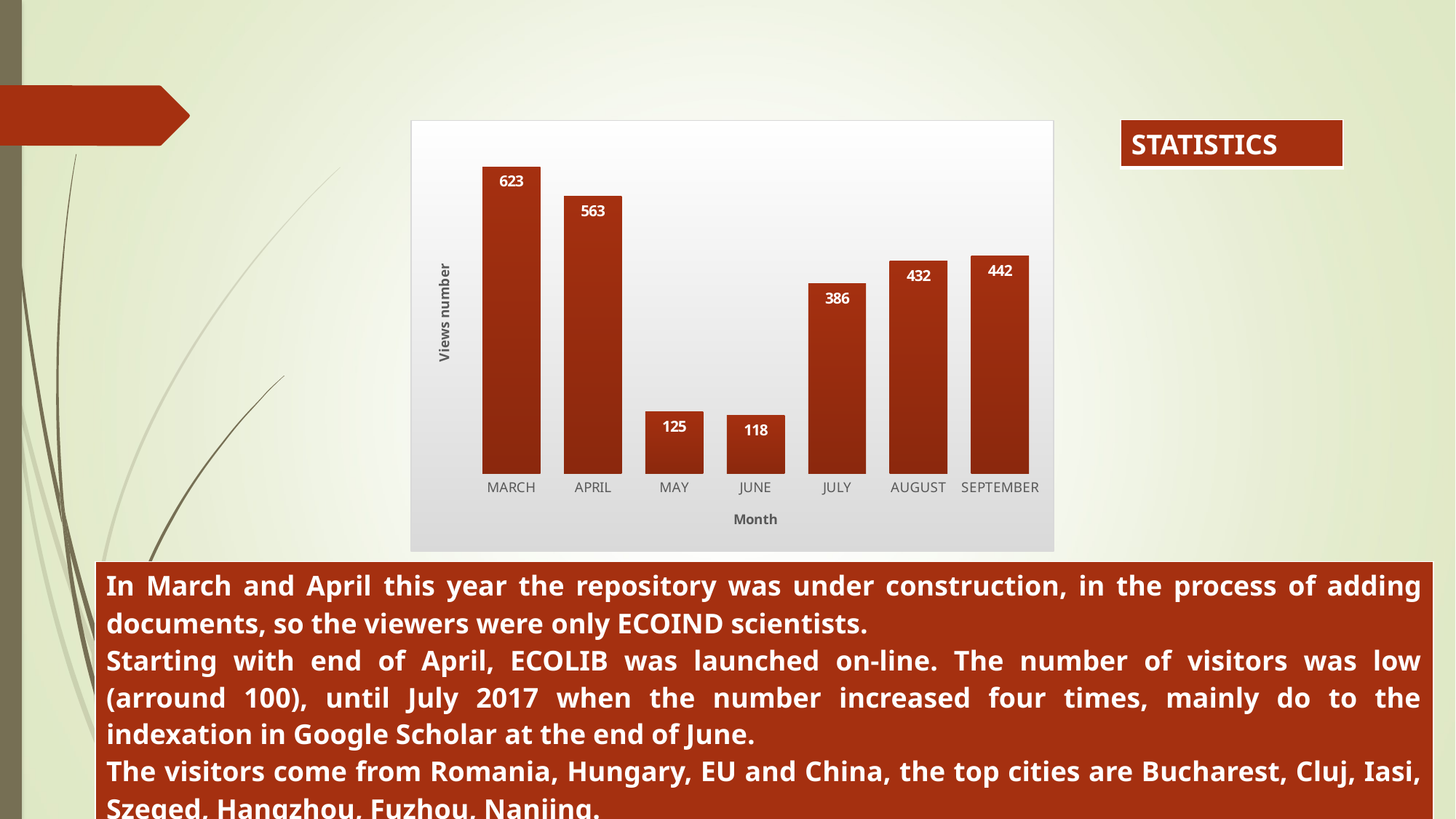
How many months are shown on the chart? 7 What is the views number for August? 432 What is the views number for June? 118 What is the difference in views number between March and April? 60 Which month has a larger views number, May or July? July What kind of chart is shown on the slide? Bar chart What is the label of the vertical axis? Views number Which month has the highest views number? March What is the views number for March? 623 What is the difference in views number between September and July? 56 Which month has the lowest views number? June Do the views numbers rise or fall from June to September? Rise